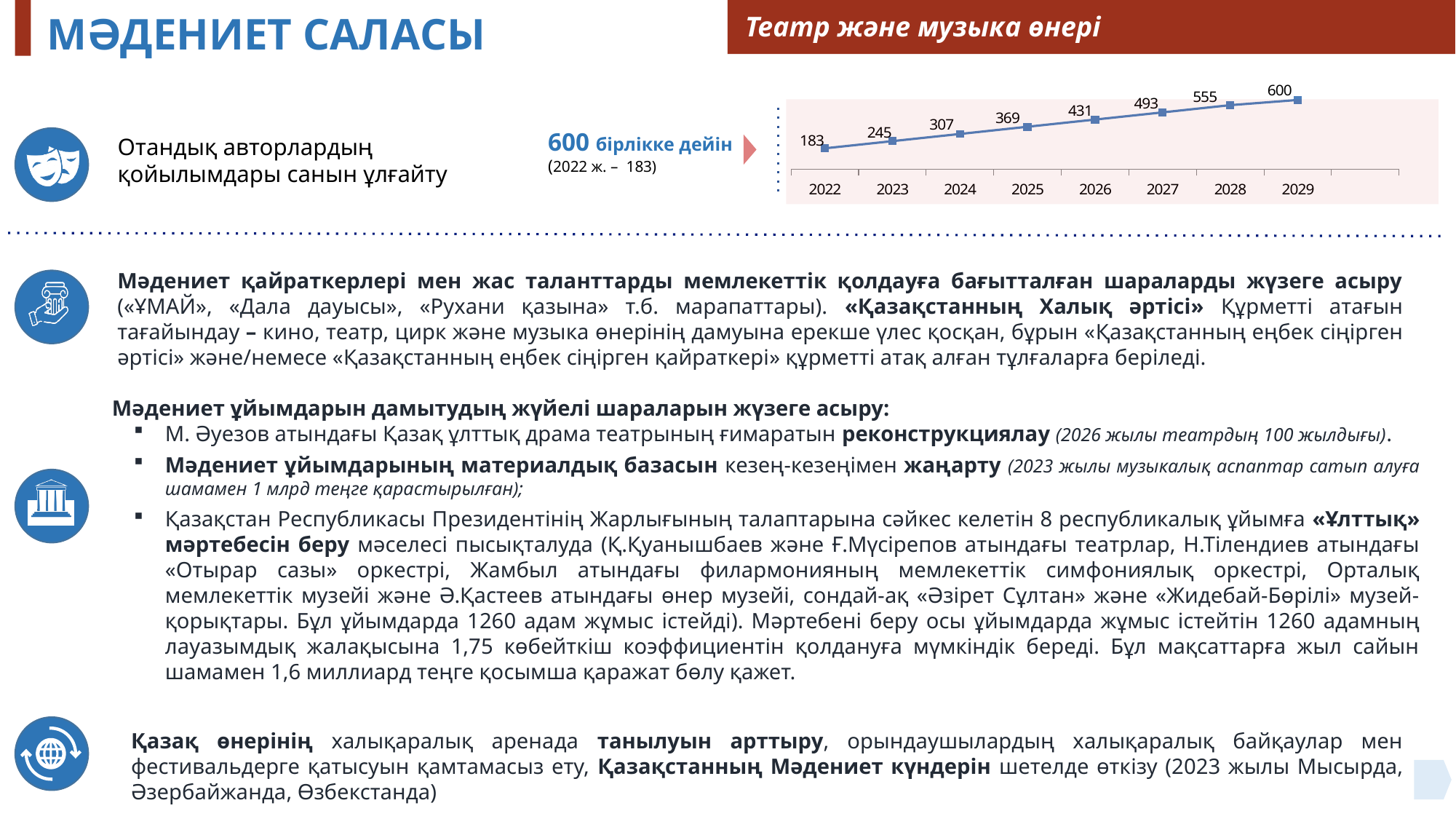
What is the difference between the values for 2024 and 2023 in the line chart? 62 Which year has the highest value in the line chart? 2029 What kind of chart is shown on the slide? line chart What is the value for 2022 in the line chart? 183 Which year has the lowest value in the line chart? 2022 What is the value for 2026 in the line chart? 431 What is the difference between the values for 2029 and 2022 in the line chart? 417 How many years are plotted in the line chart? 8 Which is larger in the line chart, the value for 2025 or the value for 2027? 2027 Do the values in the line chart rise or fall from 2022 to 2029? rise What is the value for 2028 in the line chart? 555 What is the value for 2029 in the line chart? 600